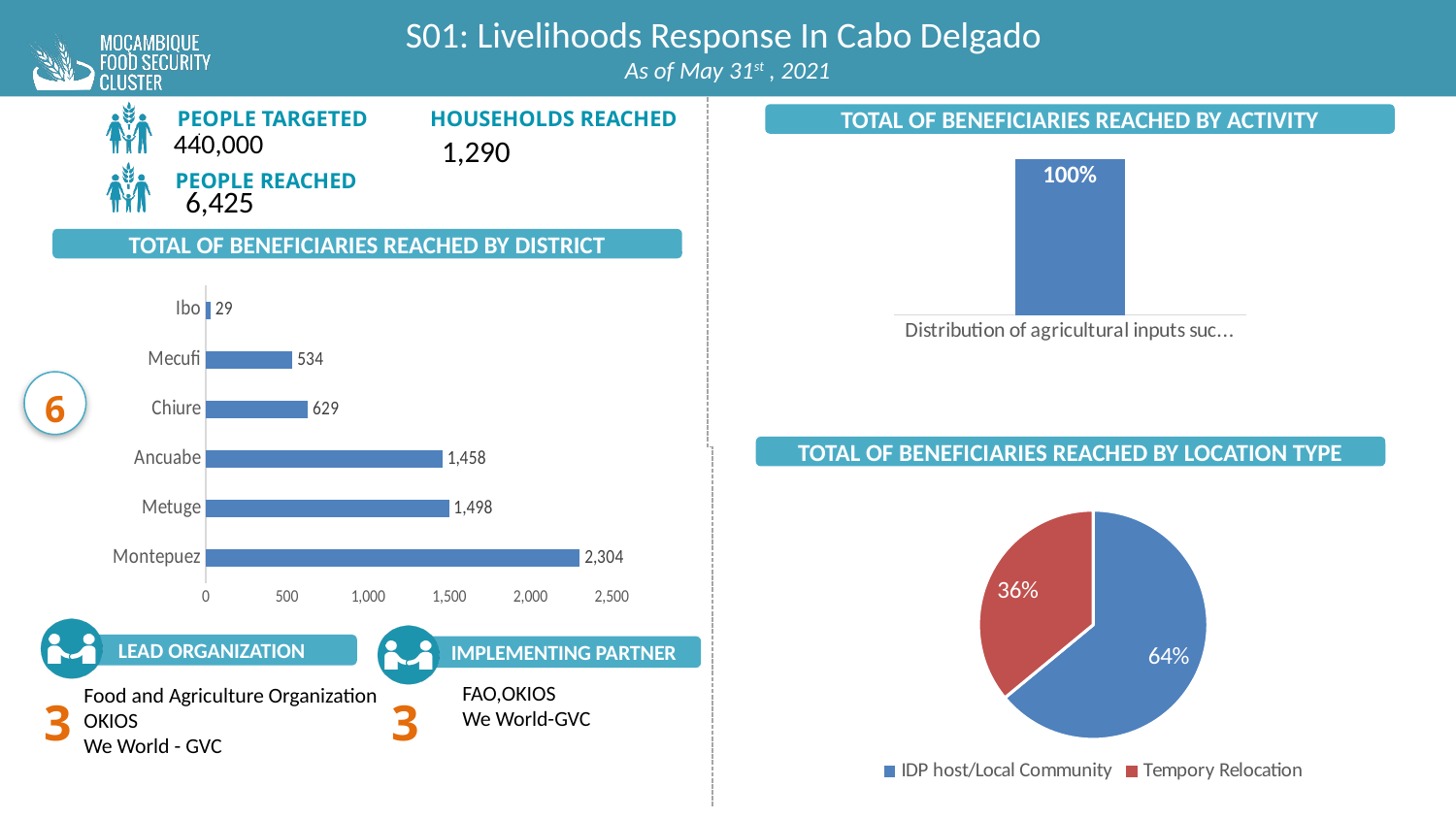
In the 'Total of Beneficiaries Reached by District' chart, which district has the highest value? Montepuez How many entries does the legend of the 'Total of Beneficiaries Reached by Location Type' pie chart list? 2 What kind of chart is the 'Total of Beneficiaries Reached by District' chart? Bar chart In the 'Total of Beneficiaries Reached by District' chart, which district has the lowest value? Ibo In the 'Total of Beneficiaries Reached by Location Type' pie chart, what share is IDP host/Local Community? 64% In the 'Total of Beneficiaries Reached by Location Type' pie chart, what share is Tempory Relocation? 36% In the 'Total of Beneficiaries Reached by District' chart, what is the difference between the values for Montepuez and Metuge? 806 How many districts are shown in the 'Total of Beneficiaries Reached by District' chart? 6 In the 'Total of Beneficiaries Reached by District' chart, what is the value for Montepuez? 2,304 In the 'Total of Beneficiaries Reached by Activity' chart, what is the value shown for the single bar? 100% In the 'Total of Beneficiaries Reached by District' chart, what is the value for Mecufi? 534 In the 'Total of Beneficiaries Reached by District' chart, which is larger, the value for Chiure or the value for Mecufi? Chiure